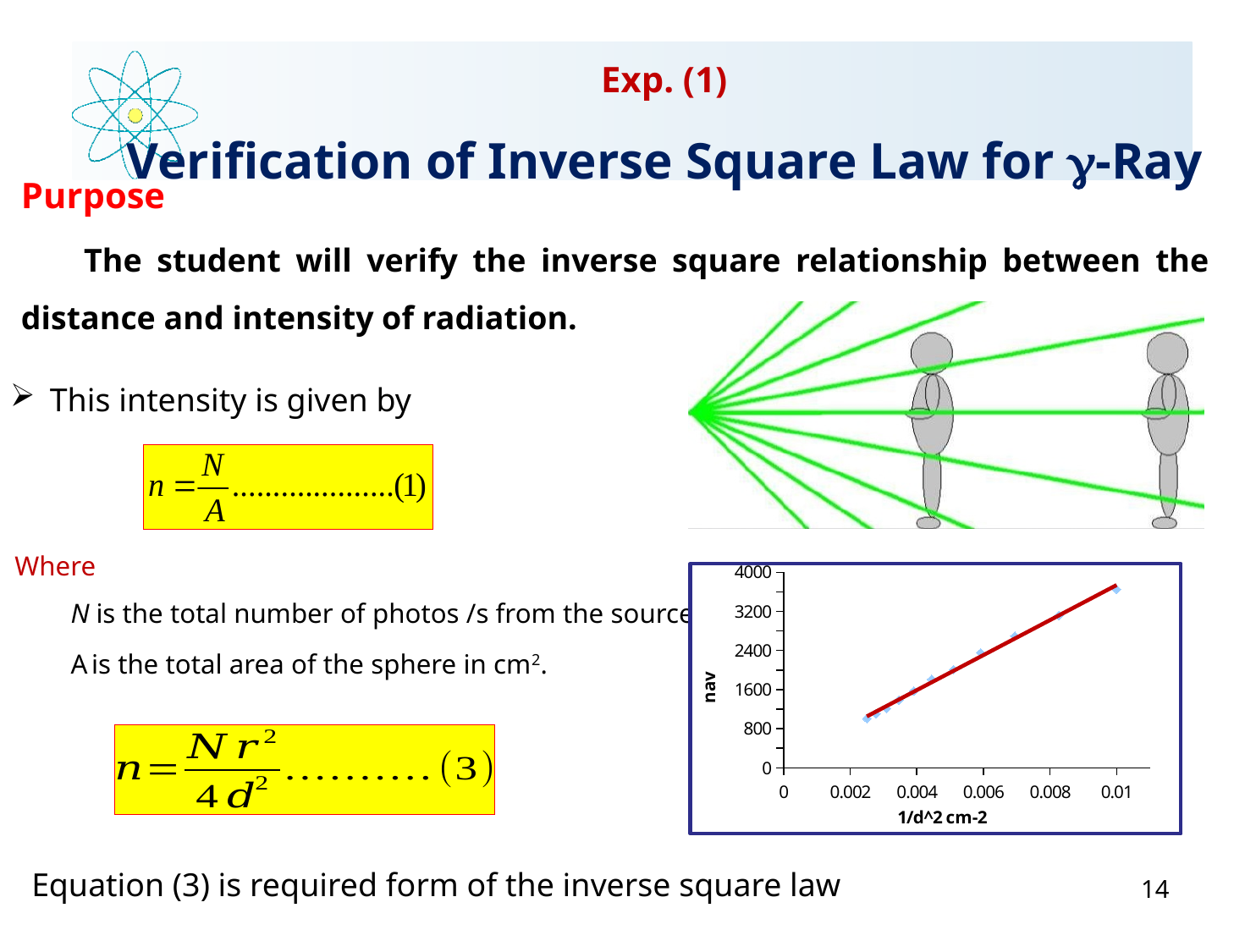
Is the nav value at 1/d^2 = 0.01 greater or less than 3200? greater Do the plotted nav values rise or fall as 1/d^2 increases along the x axis? rise Is the nav value for the leftmost data point (near 1/d^2 = 0.0025) greater or less than 1600? less Which data point has the highest nav value: the one at 1/d^2 = 0.01 or the one at 1/d^2 = 0.0025? the one at 0.01 What kind of chart is shown on the slide? scatter chart Is the nav value at 1/d^2 = 0.005 greater or less than 2400? less What is the label of the x axis of the chart? 1/d^2 cm-2 What is the highest tick value shown on the y axis of the chart? 4000 What is the label of the y axis of the chart? nav